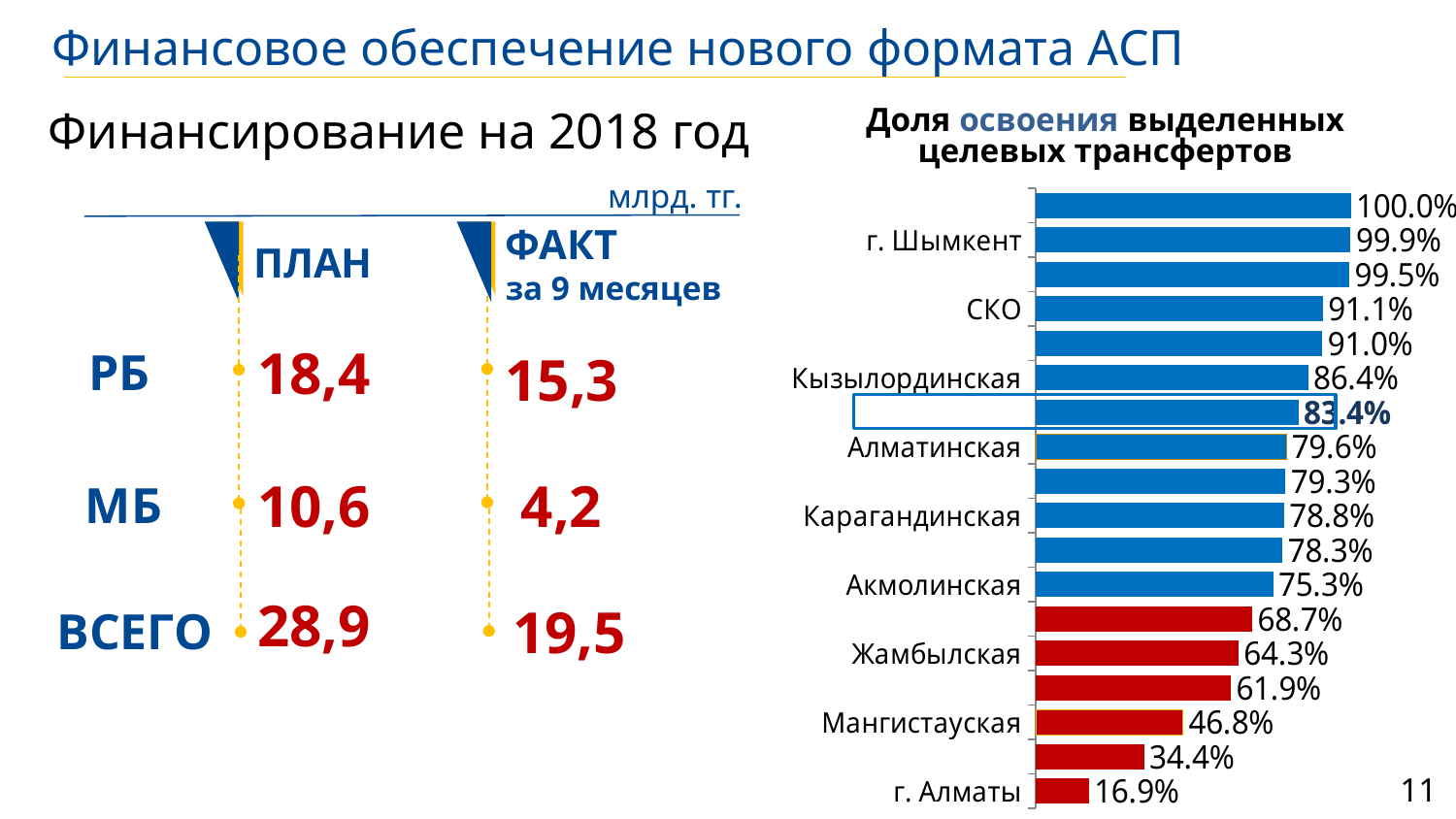
In the chart 'Доля освоения выделенных целевых трансфертов', what is the value for Кызылординская? 86.4% In the chart 'Доля освоения выделенных целевых трансфертов', what is the value for г. Алматы? 16.9% In the chart 'Доля освоения выделенных целевых трансфертов', what is the value for г. Шымкент? 99.9% In the chart 'Доля освоения выделенных целевых трансфертов', what is the highest value shown on any bar? 100.0% In the chart 'Доля освоения выделенных целевых трансфертов', what is the value for Мангистауская? 46.8% In the chart 'Доля освоения выделенных целевых трансфертов', which is larger, the value for Алматинская or the value for Карагандинская? Алматинская How many bars are plotted in the chart 'Доля освоения выделенных целевых трансфертов'? 18 In the chart 'Доля освоения выделенных целевых трансфертов', what colour are the bars with values below 70%? Red In the chart 'Доля освоения выделенных целевых трансфертов', what is the value for СКО? 91.1% In the chart 'Доля освоения выделенных целевых трансфертов', which labeled category has the lowest value? г. Алматы What kind of chart is 'Доля освоения выделенных целевых трансфертов'? Bar chart In the chart 'Доля освоения выделенных целевых трансфертов', what is the difference between the values for Акмолинская and Жамбылская? 11.0%